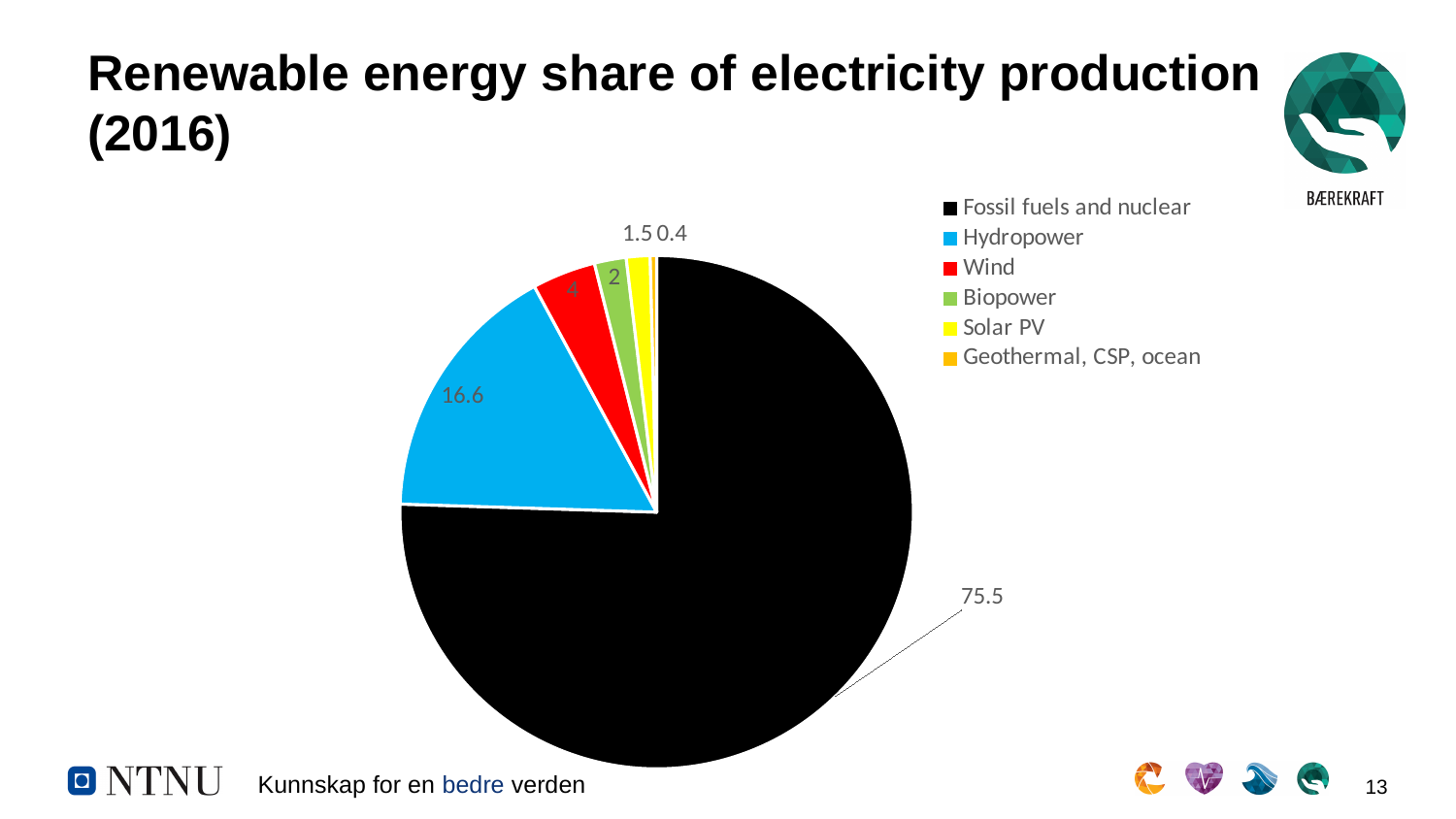
What is the value for Wind? 4 What is the value for Solar PV? 1.5 What is the value for Fossil fuels and nuclear? 75.5 What is the value for Hydropower? 16.6 What colour is the Hydropower slice? Blue Which category has the smallest slice of the pie? Geothermal, CSP, ocean Which is larger, the value for Biopower or the value for Solar PV? Biopower What type of chart is shown on the slide? Pie chart What is the difference between the values for Fossil fuels and nuclear and Hydropower? 58.9 How many categories does the legend list? 6 Which category has the largest slice of the pie? Fossil fuels and nuclear What is the difference between the values for Hydropower and Wind? 12.6